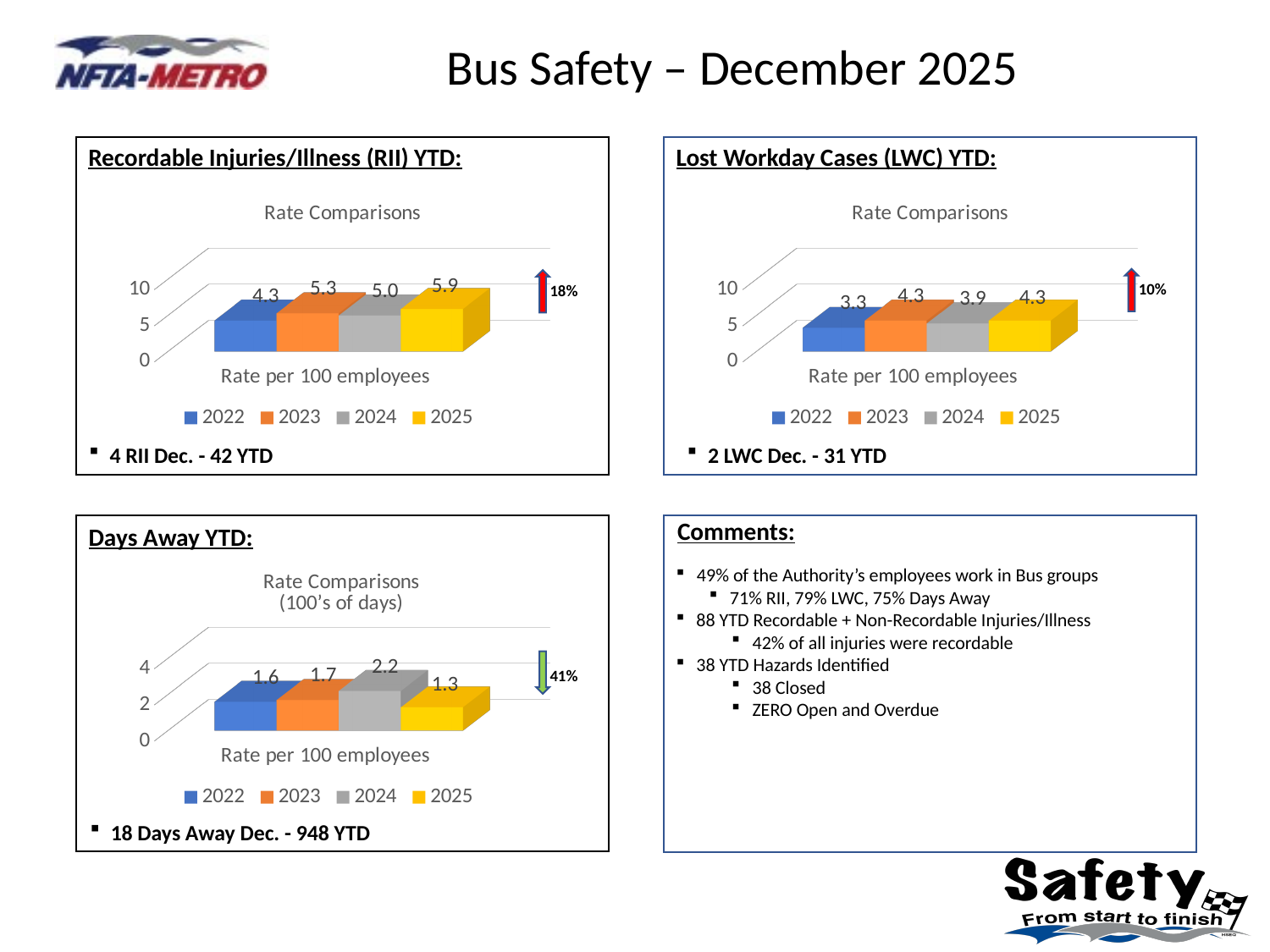
In the Recordable Injuries/Illness (RII) YTD chart, which year has the lowest rate? 2022 What kind of chart is the Lost Workday Cases (LWC) YTD chart? bar chart In the Lost Workday Cases (LWC) YTD chart, which year has the lowest rate? 2022 In the Recordable Injuries/Illness (RII) YTD chart, what is the value for 2025? 5.9 How many series does the legend list in the Days Away YTD chart? 4 In the Recordable Injuries/Illness (RII) YTD chart, what is the difference between the 2025 and 2022 values? 1.6 In the Days Away YTD chart, what is the difference between the 2024 and 2025 values? 0.9 In the Days Away YTD chart, what is the value for 2024? 2.2 In the Lost Workday Cases (LWC) YTD chart, is the 2023 value larger or smaller than the 2024 value? larger In the Lost Workday Cases (LWC) YTD chart, what is the value for 2024? 3.9 In the Days Away YTD chart, which year has the highest rate? 2024 What is the title shown above the bars in the Recordable Injuries/Illness (RII) YTD chart? Rate Comparisons